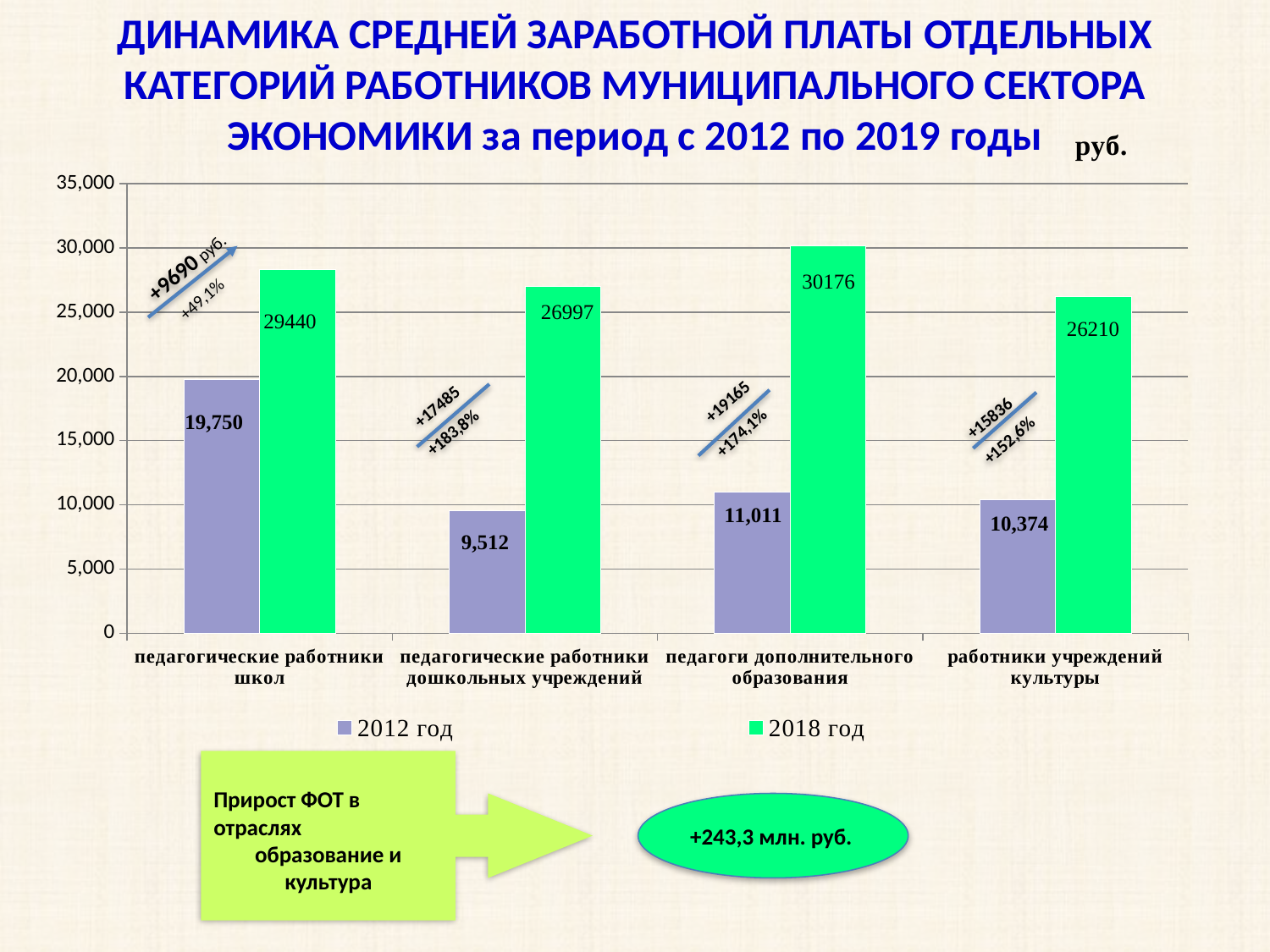
What is the difference between the 2018 год and 2012 год values for педагогические работники школ? 9690 What is the 2012 год value for работники учреждений культуры? 10,374 What is the 2018 год value for педагогические работники дошкольных учреждений? 26997 How many series does the legend list? 2 Which category has the lowest 2012 год value? педагогические работники дошкольных учреждений What is the 2012 год value for педагогические работники школ? 19,750 Which category has the highest 2018 год value? педагоги дополнительного образования What kind of chart is shown on the slide? bar chart Which is larger: the 2018 год value for работники учреждений культуры or the 2018 год value for педагогические работники дошкольных учреждений? педагогические работники дошкольных учреждений How many categories are shown on the x axis? 4 What is the 2018 год value for педагоги дополнительного образования? 30176 Is the 2012 год value for педагоги дополнительного образования greater or less than 10,000? greater